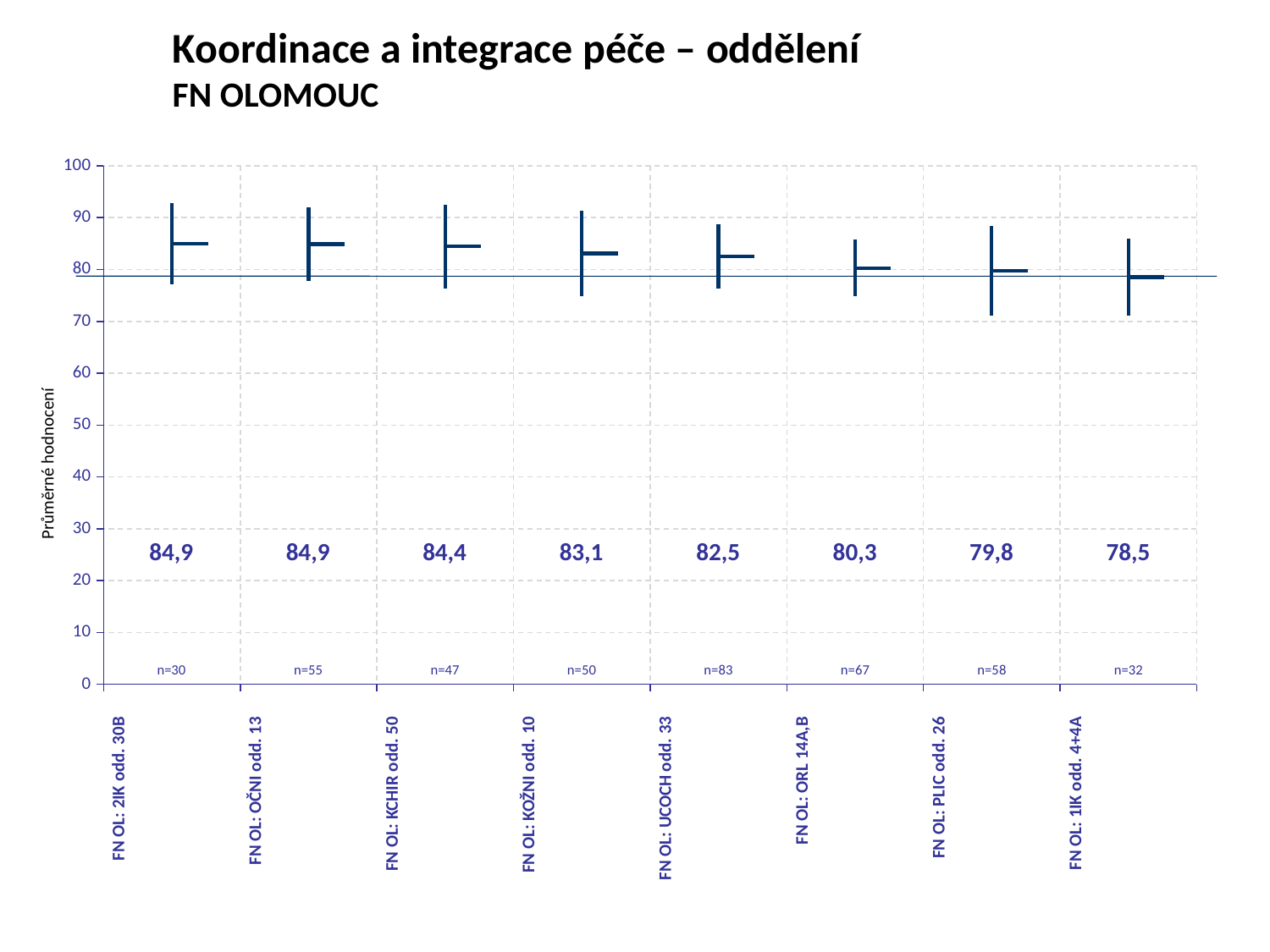
What is the difference between the average rating of FN OL: 2IK odd. 30B and FN OL: 1IK odd. 4+4A? 6,4 Do the average ratings rise or fall from left to right along the x axis? fall What is the average rating for FN OL: ORL 14A,B? 80,3 Which has a higher average rating, FN OL: PLIC odd. 26 or FN OL: KCHIR odd. 50? FN OL: KCHIR odd. 50 What is the average rating (průměrné hodnocení) for FN OL: KCHIR odd. 50? 84,4 What is the number of respondents (n) shown for FN OL: KOŽNI odd. 10? n=50 What is the number of respondents (n) shown for FN OL: UCOCH odd. 33? n=83 Which department has the lowest average rating? FN OL: 1IK odd. 4+4A What is the label of the vertical axis? Průměrné hodnocení How many departments are shown on the chart? 8 What is the difference between the average rating of FN OL: KOŽNI odd. 10 and FN OL: ORL 14A,B? 2,8 What is the average rating for FN OL: UCOCH odd. 33? 82,5